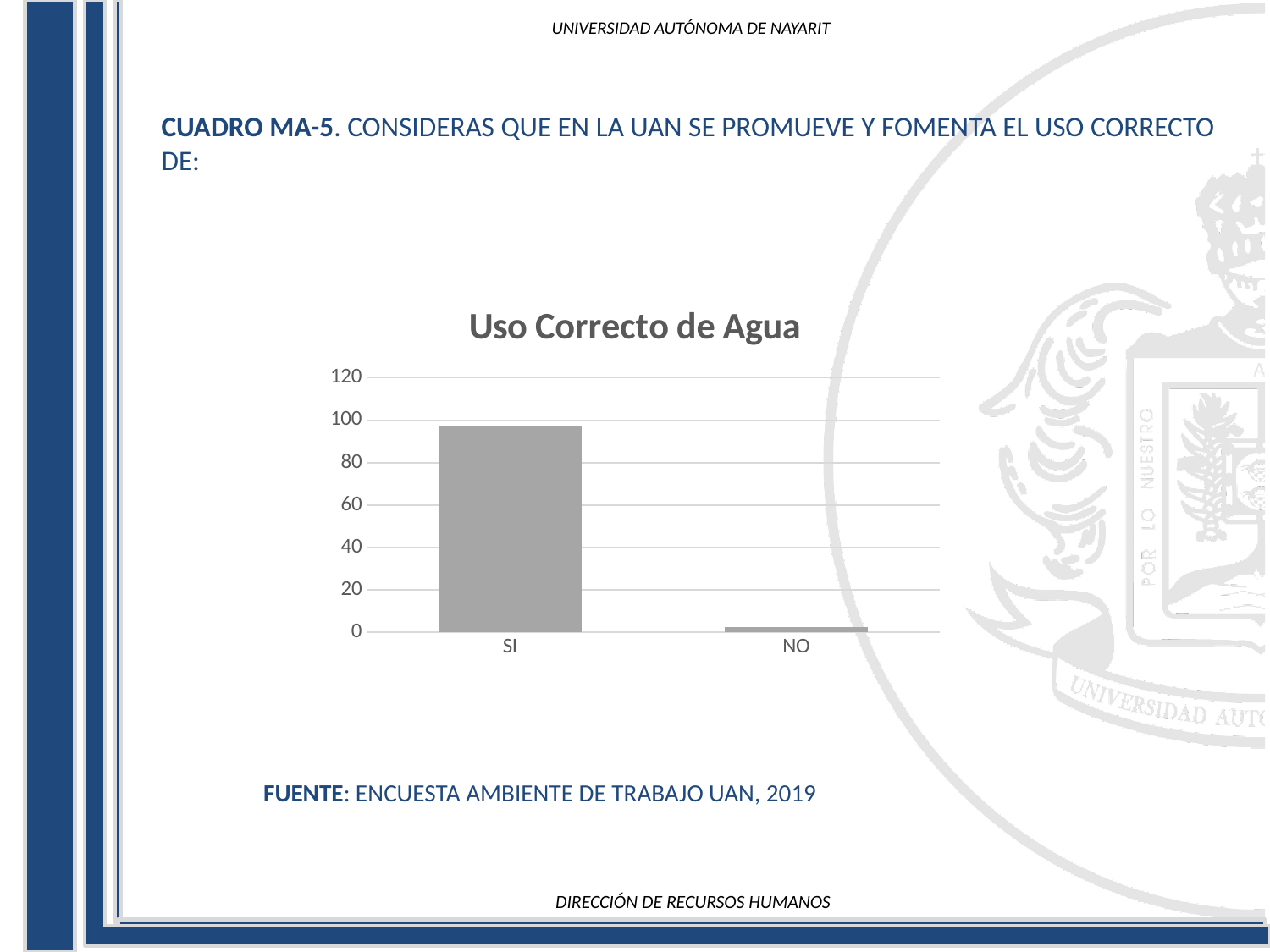
Which category has the lowest value in the chart? NO Which is larger, the value for SI or the value for NO? SI Do the values rise or fall from SI to NO along the x axis? fall What is the highest value shown on the y axis of the chart? 120 Is the value for SI greater or less than 100? less Which category has the highest value in the chart? SI How many categories are shown on the x axis of the chart? 2 Is the value for NO greater or less than 20? less What is the title of the chart? Uso Correcto de Agua What kind of chart is shown on the slide? bar chart Is the value for SI greater or less than 80? greater